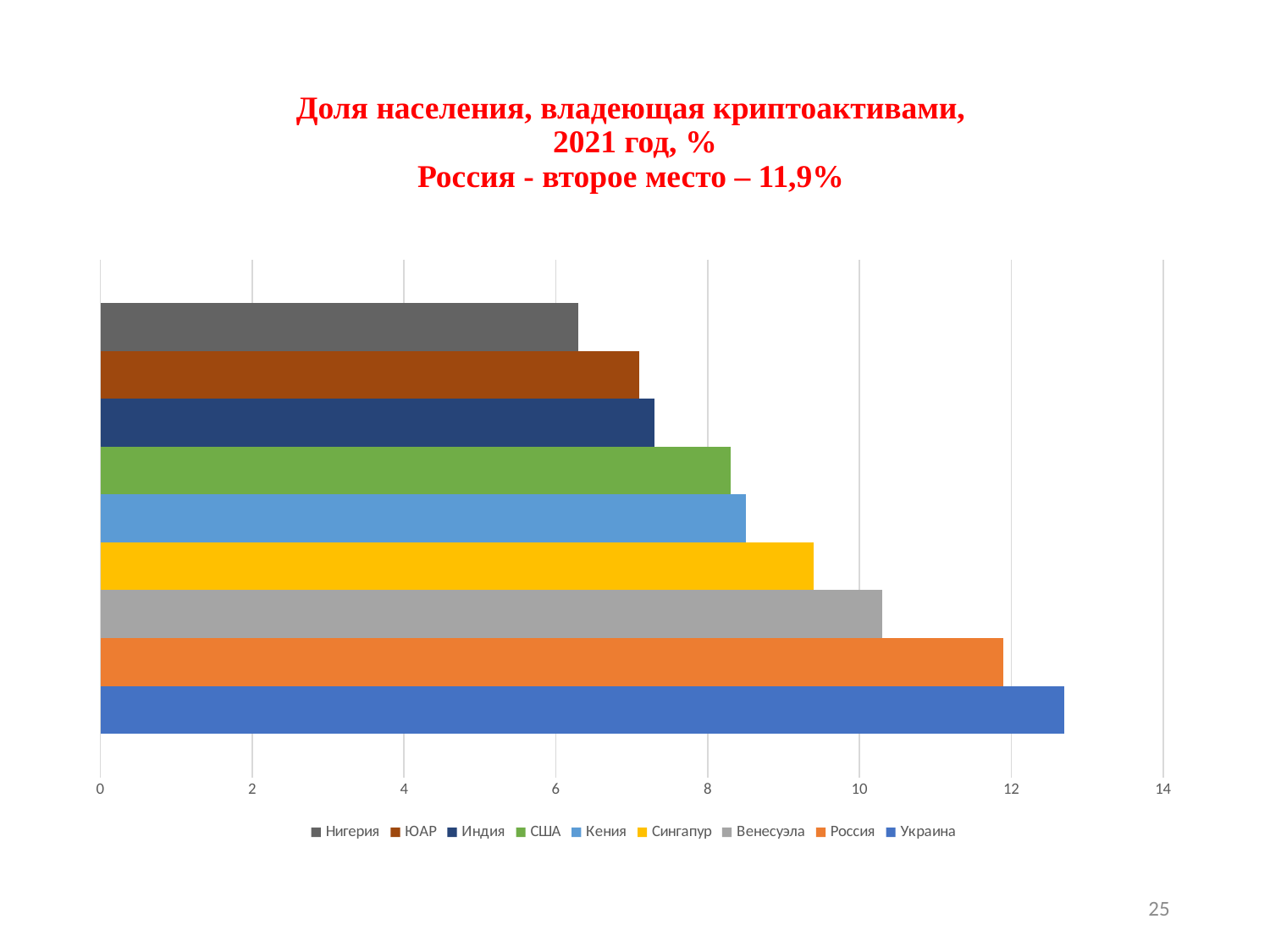
Which is larger, the value for Украина or the value for Нигерия? Украина Is the value for Сингапур greater or less than 10? less Is the value for Украина greater or less than 12? greater Which is larger, the value for Сингапур or the value for ЮАР? Сингапур Which country has the lowest share of population owning crypto assets? Нигерия According to the slide title, what is the value for Россия? 11,9% What kind of chart is shown on the slide? bar chart Is the value for Венесуэла greater or less than 10? greater Which country has the highest share of population owning crypto assets? Украина How many series does the legend list? 9 Which year does the chart title say the data refers to? 2021